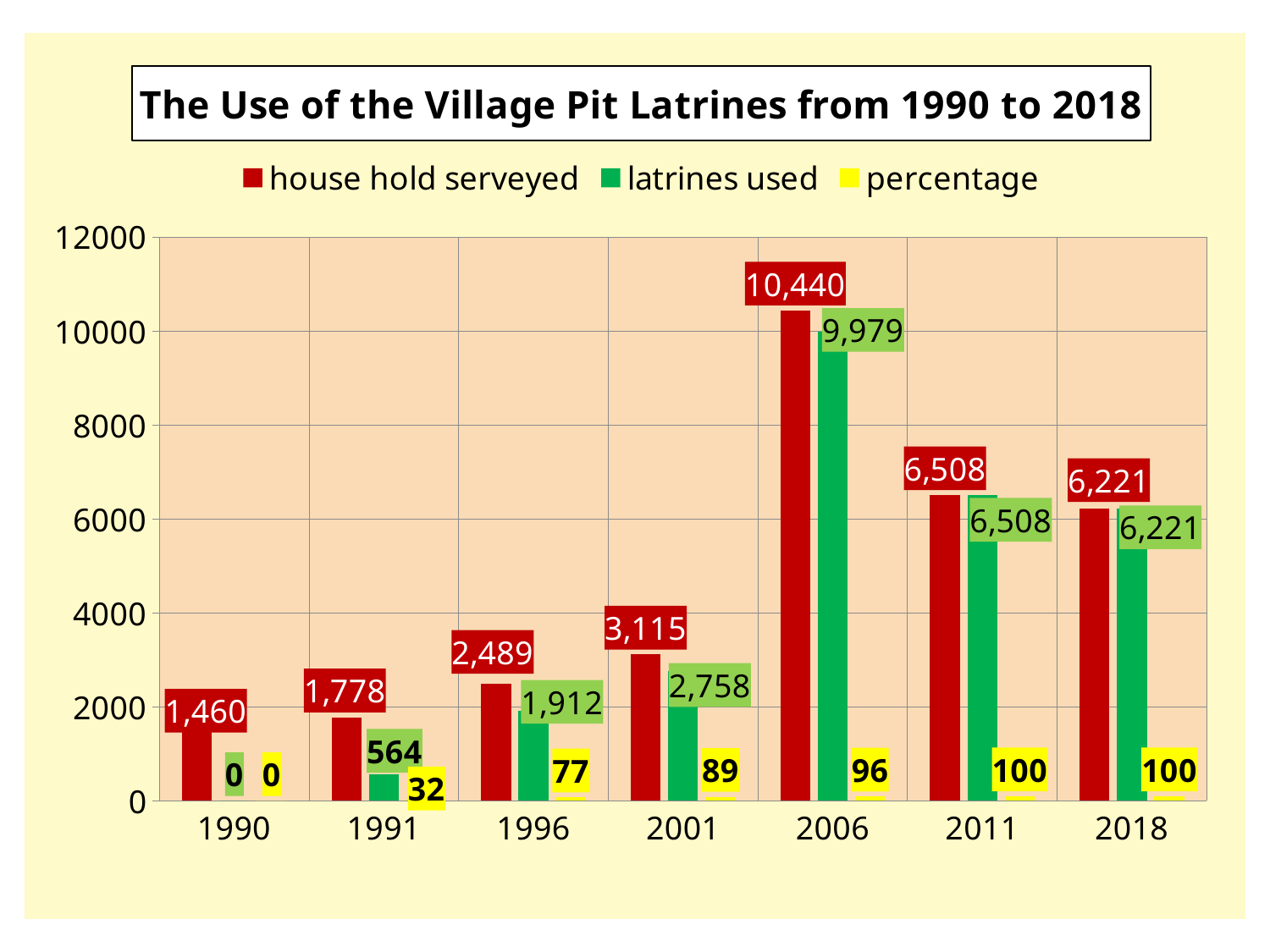
What is the percentage value for 1991? 32 Is the value for house hold serveyed in 2006 greater or less than 10000? greater What is the value for latrines used in 2001? 2,758 How many series does the legend list? 3 How many years are shown on the x axis? 7 What kind of chart is shown on the slide? bar chart What is the value for house hold serveyed in 2006? 10,440 What is the difference between house hold serveyed and latrines used in 1996? 577 Which year has the highest value for latrines used? 2006 Which is larger, house hold serveyed in 2011 or house hold serveyed in 2018? house hold serveyed in 2011 Which year has the lowest value for house hold serveyed? 1990 What is the title of the chart? The Use of the Village Pit Latrines from 1990 to 2018